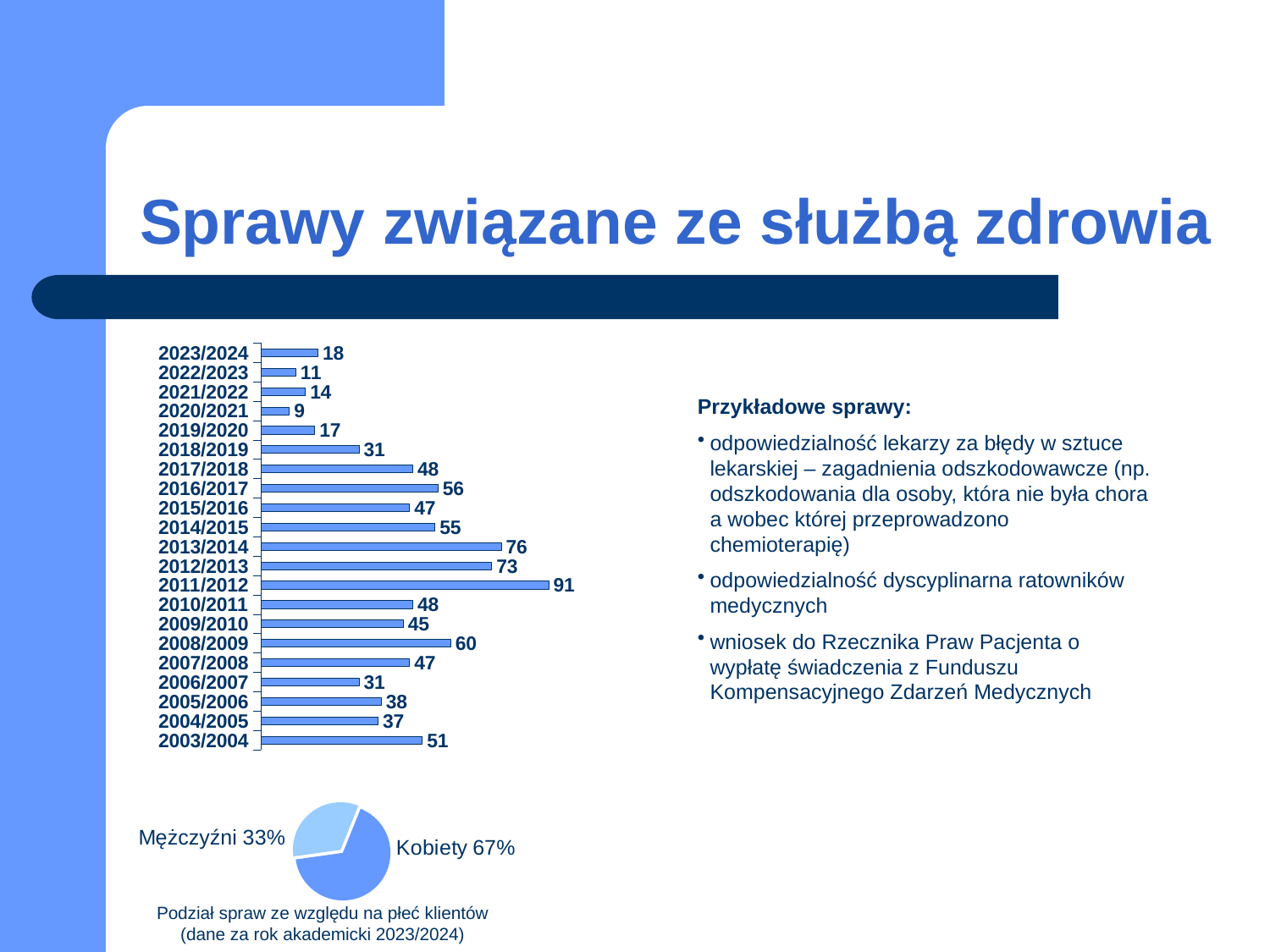
In the pie chart, what share is labelled Mężczyźni? 33% In the bar chart, which academic year has the highest value? 2011/2012 In the bar chart, what is the value for 2020/2021? 9 In the pie chart, what share is labelled Kobiety? 67% What kind of chart is the chart at the top left of the slide? bar chart What kind of chart is the chart at the bottom left of the slide? pie chart How many academic years are shown in the bar chart? 21 In the bar chart, which is larger, the value for 2016/2017 or the value for 2014/2015? 2016/2017 In the bar chart, what is the value for 2011/2012? 91 In the bar chart, which academic year has the lowest value? 2020/2021 In the bar chart, what is the difference between the values for 2013/2014 and 2012/2013? 3 In the bar chart, what is the value for 2023/2024? 18